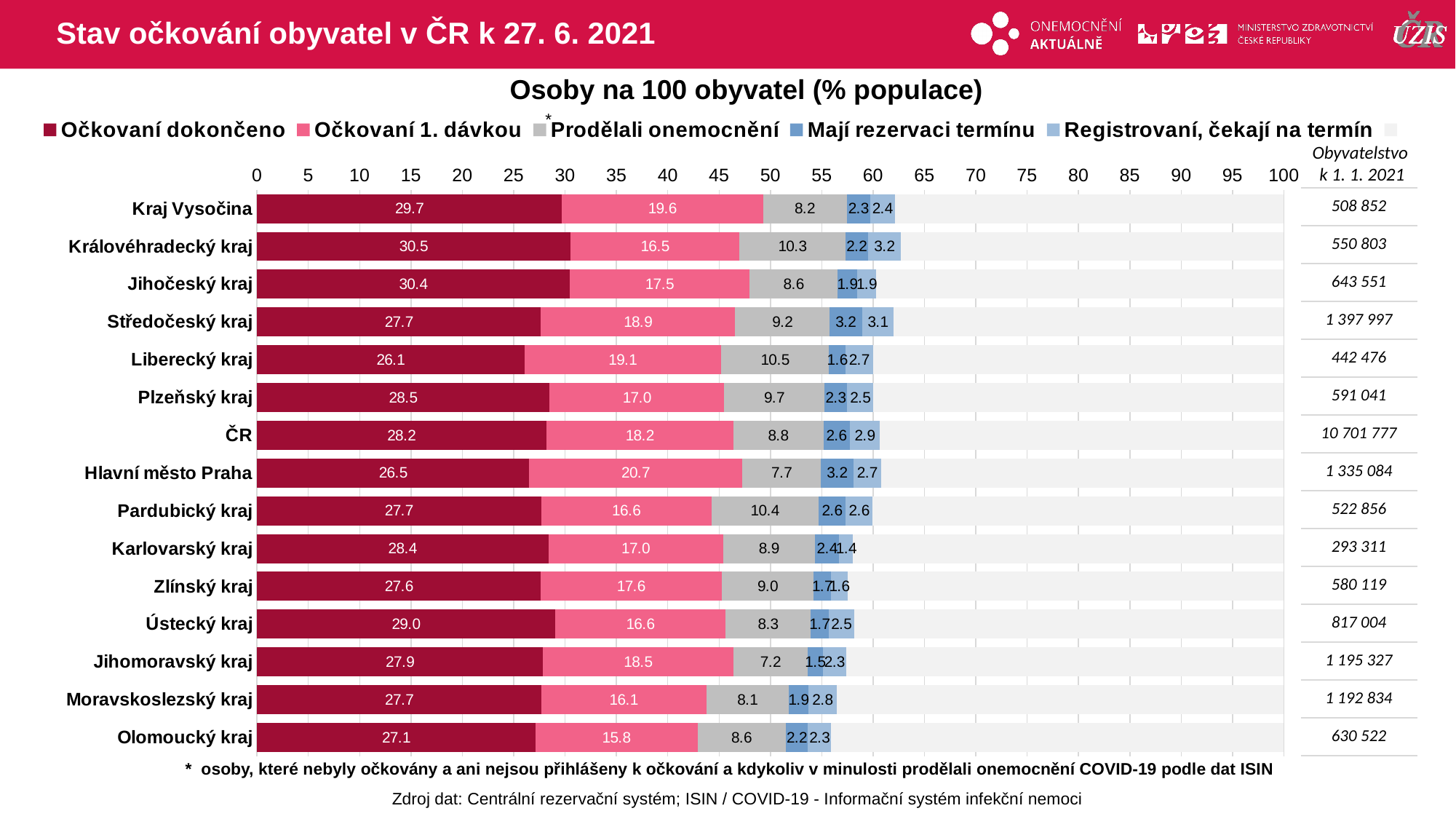
Which category has the highest value for Očkovaní 1. dávkou? Hlavní město Praha What is the value of Mají rezervaci termínu for ČR? 2.6 What is the title of the chart? Osoby na 100 obyvatel (% populace) What is the difference between the Očkovaní dokončeno values for Kraj Vysočina and Olomoucký kraj? 2.6 How many categories (rows) are shown in the chart? 15 What is the value of Očkovaní dokončeno for Kraj Vysočina? 29.7 Which has a larger Očkovaní dokončeno value, Kraj Vysočina or Liberecký kraj? Kraj Vysočina What kind of chart is shown on the slide? Stacked bar chart What is the value of Prodělali onemocnění for Královéhradecký kraj? 10.3 What is the value of Očkovaní 1. dávkou for Hlavní město Praha? 20.7